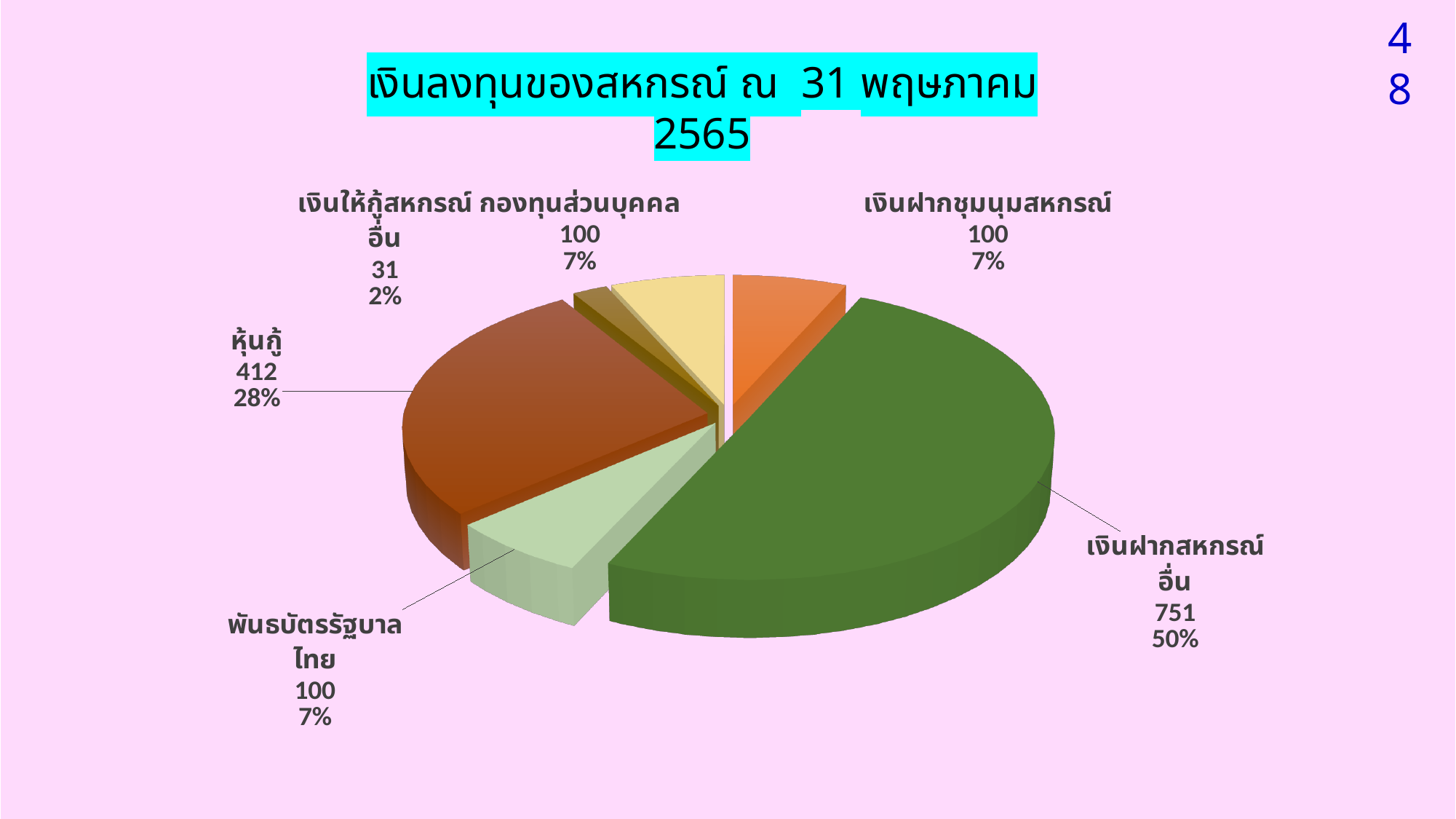
What is the value for พันธบัตรรัฐบาลไทย? 100 Which is larger, the value for หุ้นกู้ or the value for กองทุนส่วนบุคคล? หุ้นกู้ What is the value for หุ้นกู้? 412 What is the value for เงินให้กู้สหกรณ์อื่น? 31 What is the difference between the values for เงินฝากสหกรณ์อื่น and หุ้นกู้? 339 Which category has the smallest slice of the pie? เงินให้กู้สหกรณ์อื่น How many categories are shown in the pie chart? 6 Which category has the largest slice of the pie? เงินฝากสหกรณ์อื่น What share of the pie does หุ้นกู้ represent? 28% What kind of chart is shown on the slide? pie chart What share of the pie does เงินฝากชุมนุมสหกรณ์ represent? 7% What is the value for เงินฝากสหกรณ์อื่น? 751